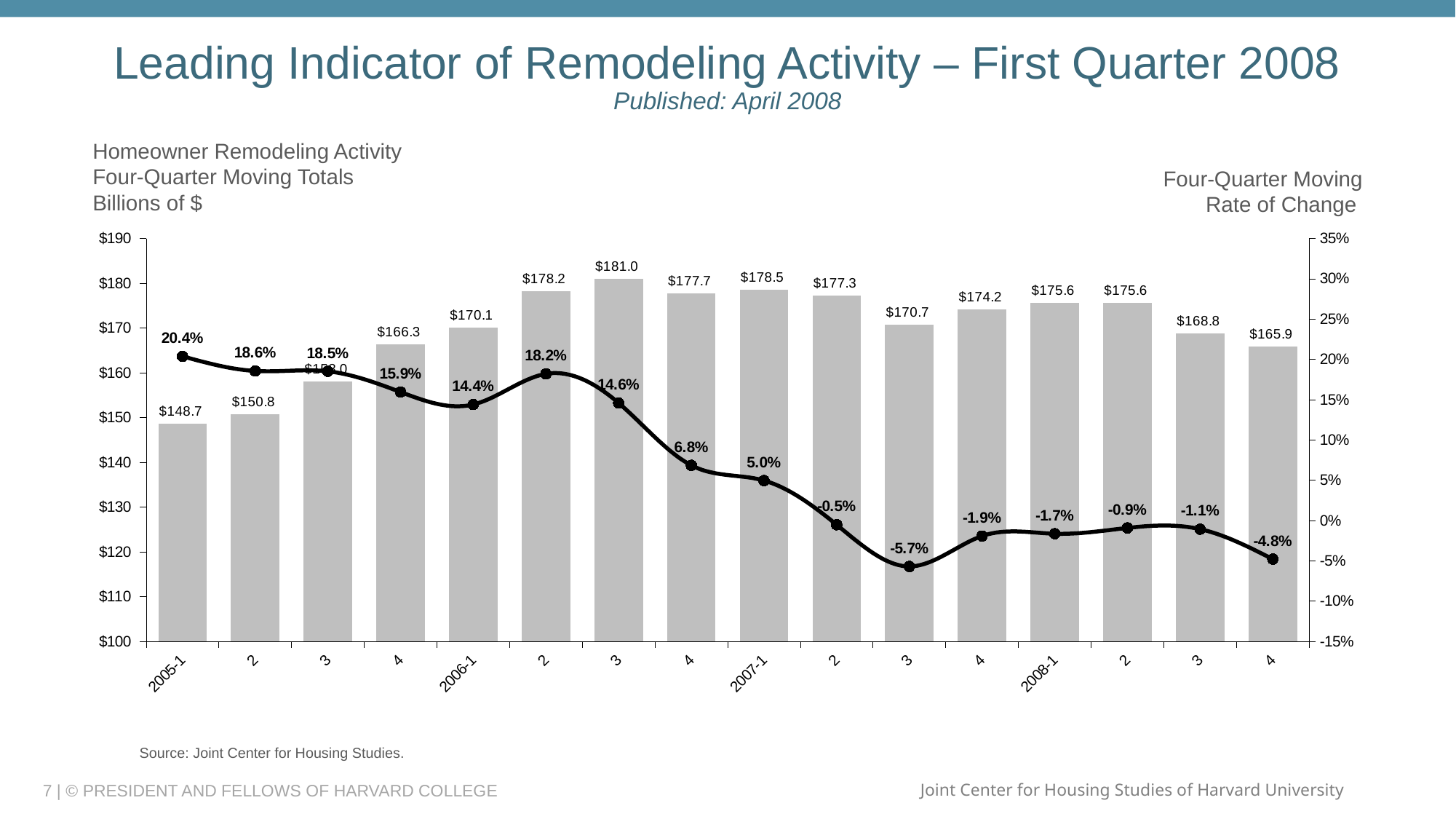
How many quarters are plotted on the x axis? 16 Which quarter has the highest four-quarter moving rate of change? 2005-1 Which is larger, the four-quarter moving total for 2007-1 or for 2008-1? 2007-1 Which quarter has the highest four-quarter moving total? 2006-3 What unit is shown on the left axis for the bars? Billions of $ What is the four-quarter moving rate of change for 2007-3? -5.7% What is the four-quarter moving total for 2006-3? $181.0 What is the difference between the four-quarter moving totals for 2006-3 and 2005-1? $32.3 What is the four-quarter moving rate of change for 2008-4? -4.8% Which quarter has the lowest four-quarter moving total? 2005-1 Does the rate of change line generally rise or fall from 2005-1 to 2008-4? fall What is the four-quarter moving total for 2008-2? $175.6